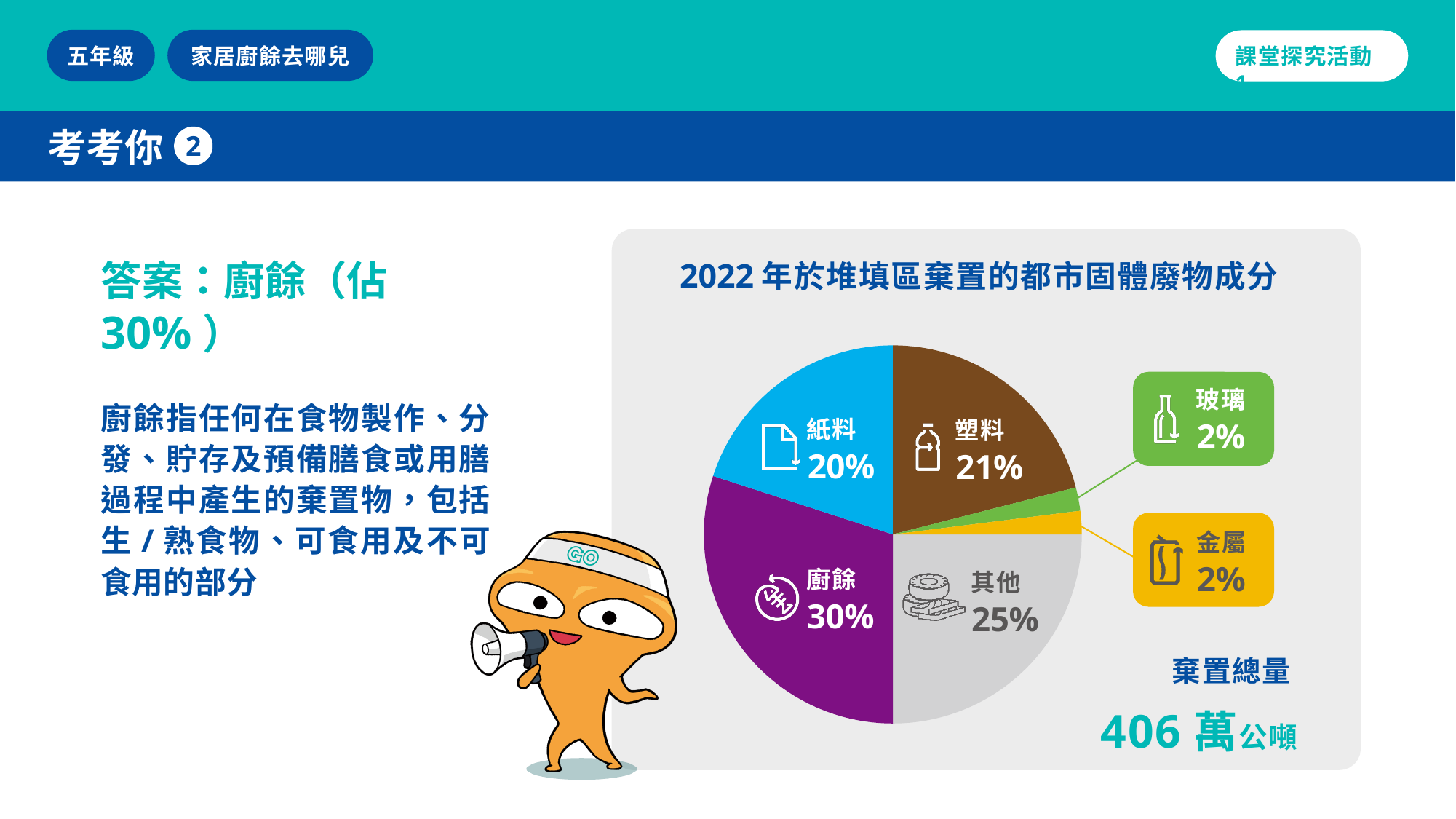
What kind of chart is shown on the slide? pie chart What total disposal quantity (棄置總量) is shown next to the chart? 406 萬公噸 What is the title of the chart? 2022 年於堆填區棄置的都市固體廢物成分 What percentage is shown for 紙料? 20% What percentage is shown for 塑料? 21% What is the difference in percentage points between 廚餘 and 紙料? 10 Which category has the largest slice of the pie? 廚餘 Which is larger, the share for 其他 or the share for 塑料? 其他 What percentage is shown for 其他? 25% What percentage is shown for 玻璃? 2% What share of the pie does 廚餘 account for? 30% How many categories are shown in the pie chart? 6